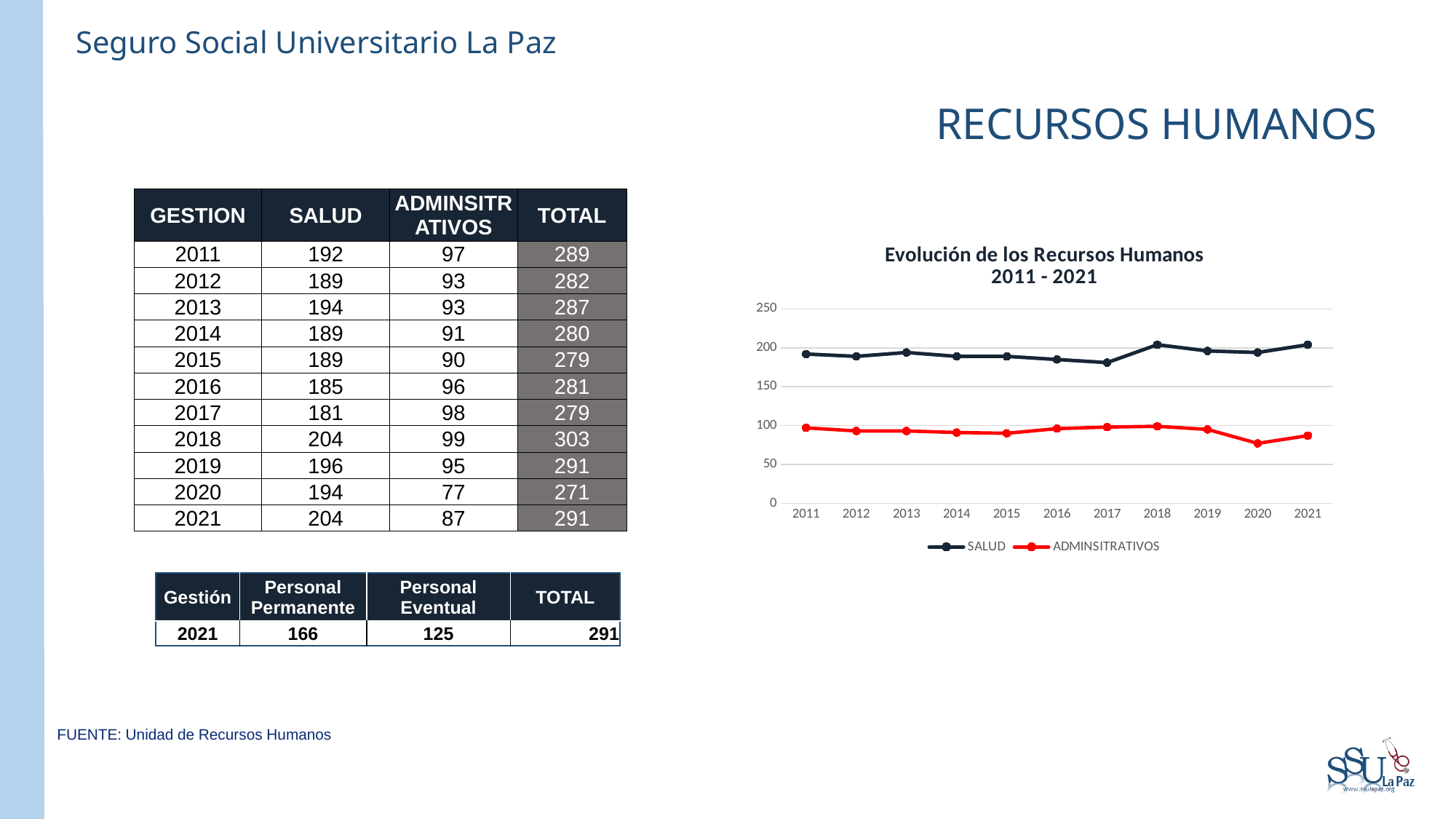
Is the SALUD value for 2018 greater or less than 200? greater How many years are plotted along the x axis of the chart? 11 Which series is drawn in red in the chart? ADMINSITRATIVOS Is the ADMINSITRATIVOS value for 2020 greater or less than 100? less How many series does the legend of the chart list? 2 Does the ADMINSITRATIVOS series rise or fall between 2019 and 2020? fall In which year does the ADMINSITRATIVOS series reach its lowest point? 2020 What kind of chart is 'Evolución de los Recursos Humanos 2011 - 2021'? line chart Which series has higher values throughout the chart, SALUD or ADMINSITRATIVOS? SALUD What is the difference between the SALUD and ADMINSITRATIVOS values for 2021, using the values printed in the table? 117 In which year does the SALUD series reach its lowest point? 2017 What is the SALUD value for 2018, as printed in the table on the slide? 204